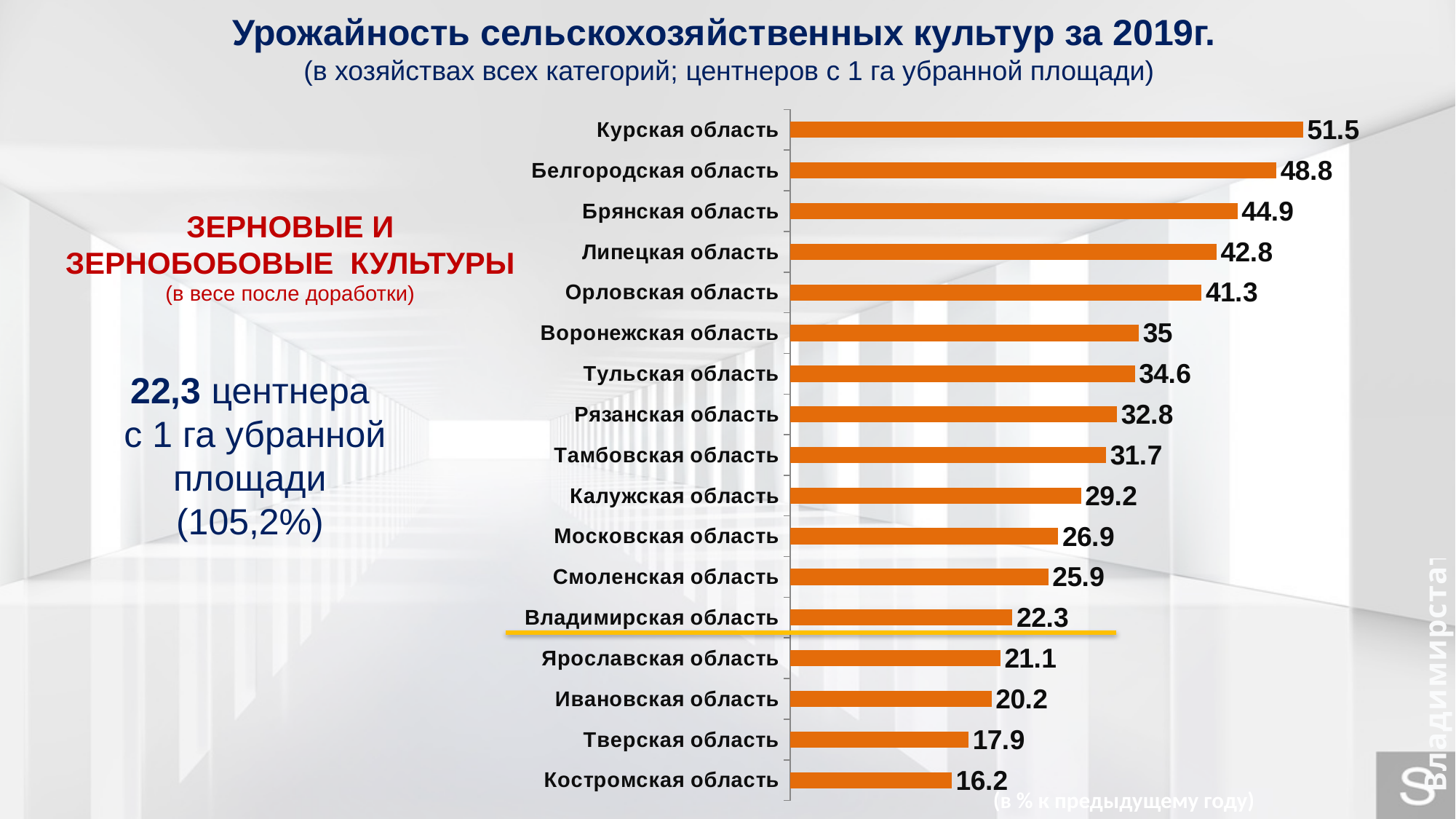
What is the value for Владимирская область? 22.3 Which region has the lowest value? Костромская область How many regions are shown in the chart? 17 Do the values rise or fall going from the top bar to the bottom bar? Fall Which region has the highest value? Курская область What is the value for Курская область? 51.5 Which is larger, the value for Воронежская область or Тульская область? Воронежская область What kind of chart is shown on the slide? Bar chart What is the difference between the values for Курская область and Костромская область? 35.3 What is the value for Тверская область? 17.9 Which is larger, the value for Московская область or Калужская область? Калужская область What is the difference between the values for Владимирская область and Ярославская область? 1.2